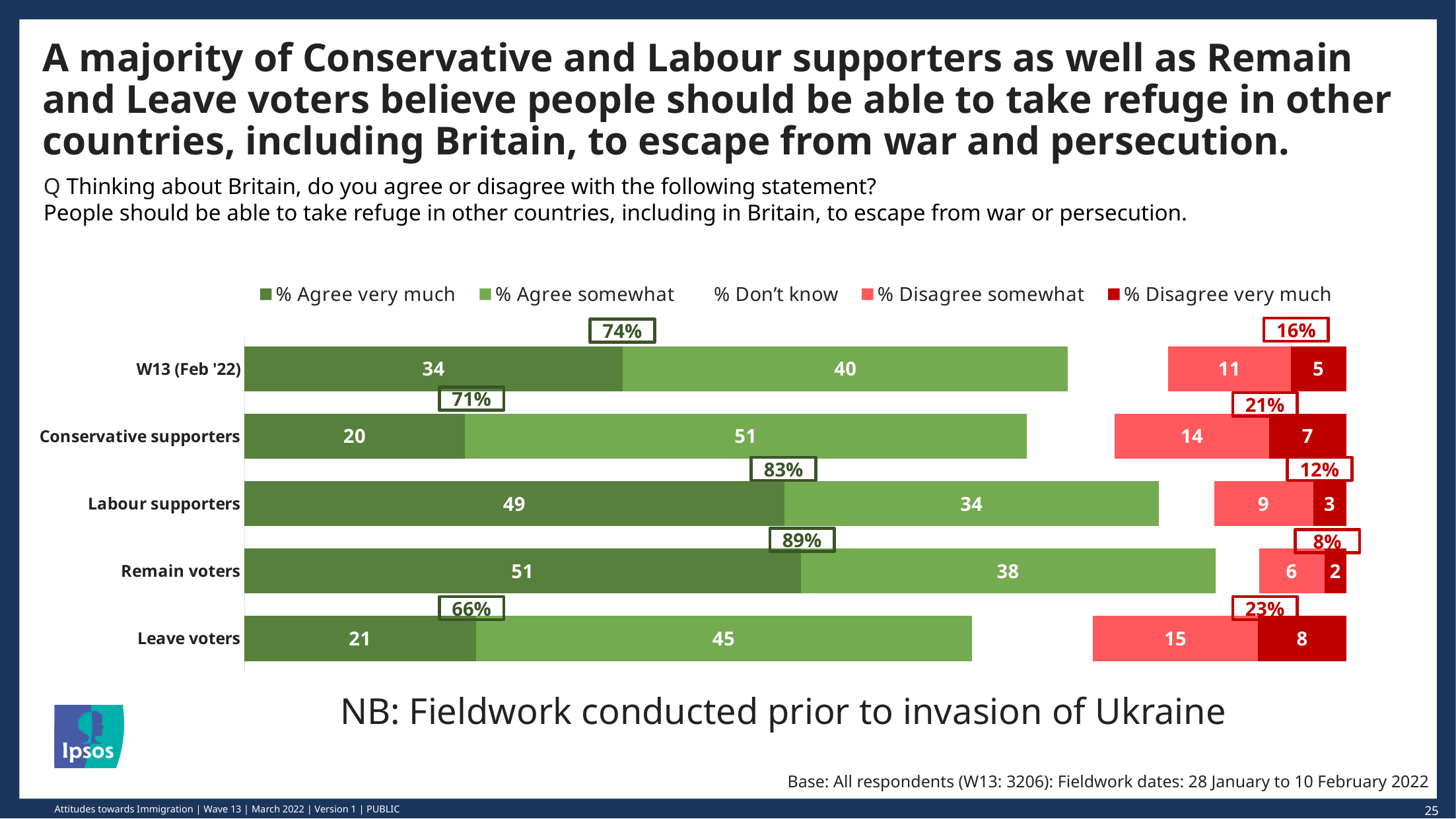
What is the % Agree somewhat value for Conservative supporters? 51 Which is larger: the % Disagree somewhat value for Conservative supporters or for Labour supporters? Conservative supporters What is the combined agree percentage shown above the bar for Remain voters? 89% What is the % Disagree somewhat value for Leave voters? 15 Which category has the highest % Agree very much value? Remain voters How many categories are shown on the chart? 5 What kind of chart is shown on the slide? Stacked bar chart What is the % Disagree very much value for Remain voters? 2 How many series does the legend list? 5 What is the % Agree very much value for Labour supporters? 49 Which category has the lowest % Agree very much value? Conservative supporters What is the difference between the % Agree somewhat values for Leave voters and Labour supporters? 11